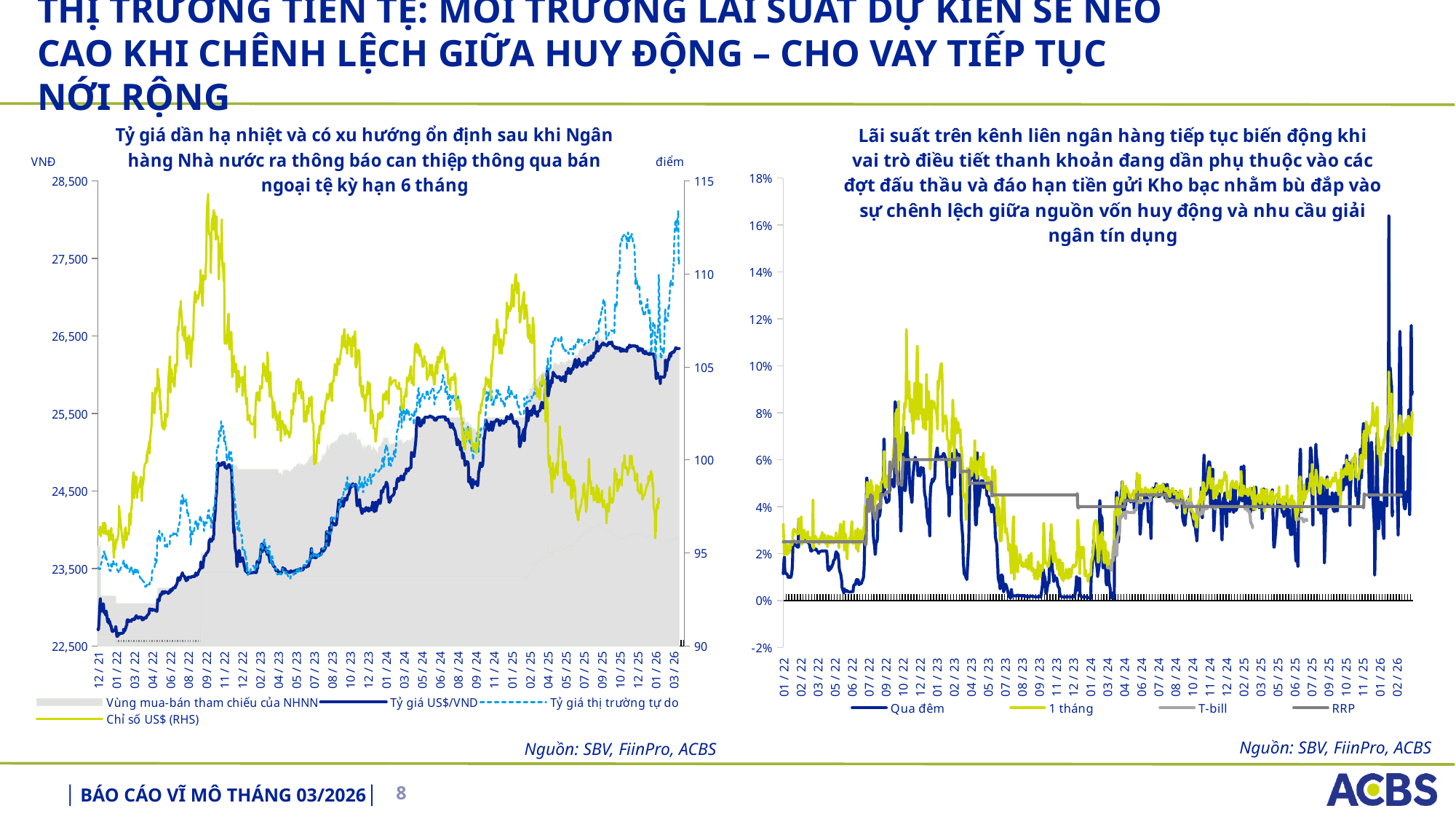
In the left exchange-rate chart, which series is plotted on the right-hand axis (RHS) according to the legend? Chỉ số US$ (RHS) In the left exchange-rate chart, is the Chỉ số US$ (RHS) value at 03/26 greater or less than 100? less What kind of chart is the right chart about interbank interest rates (Lãi suất trên kênh liên ngân hàng)? Line chart In the left exchange-rate chart, does the Tỷ giá US$/VND series overall rise or fall from 12/21 to 03/26? Rise In the left exchange-rate chart, is the value of Tỷ giá US$/VND at 12/21 greater or less than 23,500? less In the right interbank-rate chart, is the peak of the Qua đêm series in early 2026 greater or less than 14%? greater How many series does the legend of the left exchange-rate chart list? 4 How many series does the legend of the right interbank-rate chart list? 4 In the right interbank-rate chart, which series is shown in dark blue according to the legend? Qua đêm What kind of chart is the left chart about the exchange rate (Tỷ giá)? Line chart